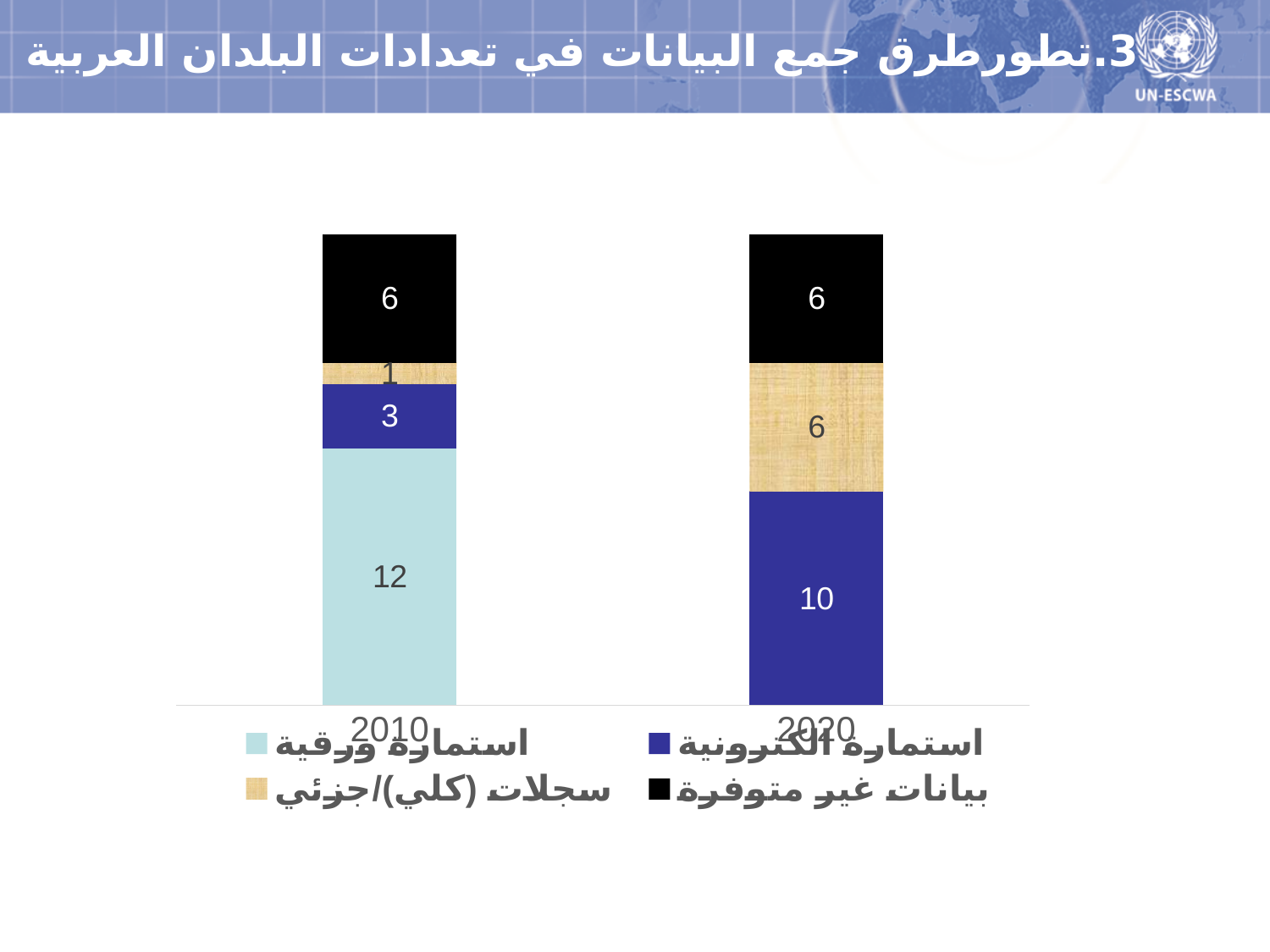
What is the value for سجلات (كلي)/جزئي (registers) in 2010? 1 How many categories (years) are shown on the x axis? 2 What is the value for بيانات غير متوفرة (data not available) in 2020? 6 What is the total of the stacked bar for 2020? 22 How many series does the legend list? 4 What is the value for استمارة الكترونية (electronic questionnaire) in 2020? 10 What type of chart is shown on the slide? stacked bar chart What is the total of the stacked bar for 2010? 22 Which is larger: the registers value in 2010 or in 2020? 2020 What is the value for استمارة ورقية (paper questionnaire) in 2010? 12 Which series is shown in black in the legend? بيانات غير متوفرة What is the difference between the electronic questionnaire value in 2020 and in 2010? 7